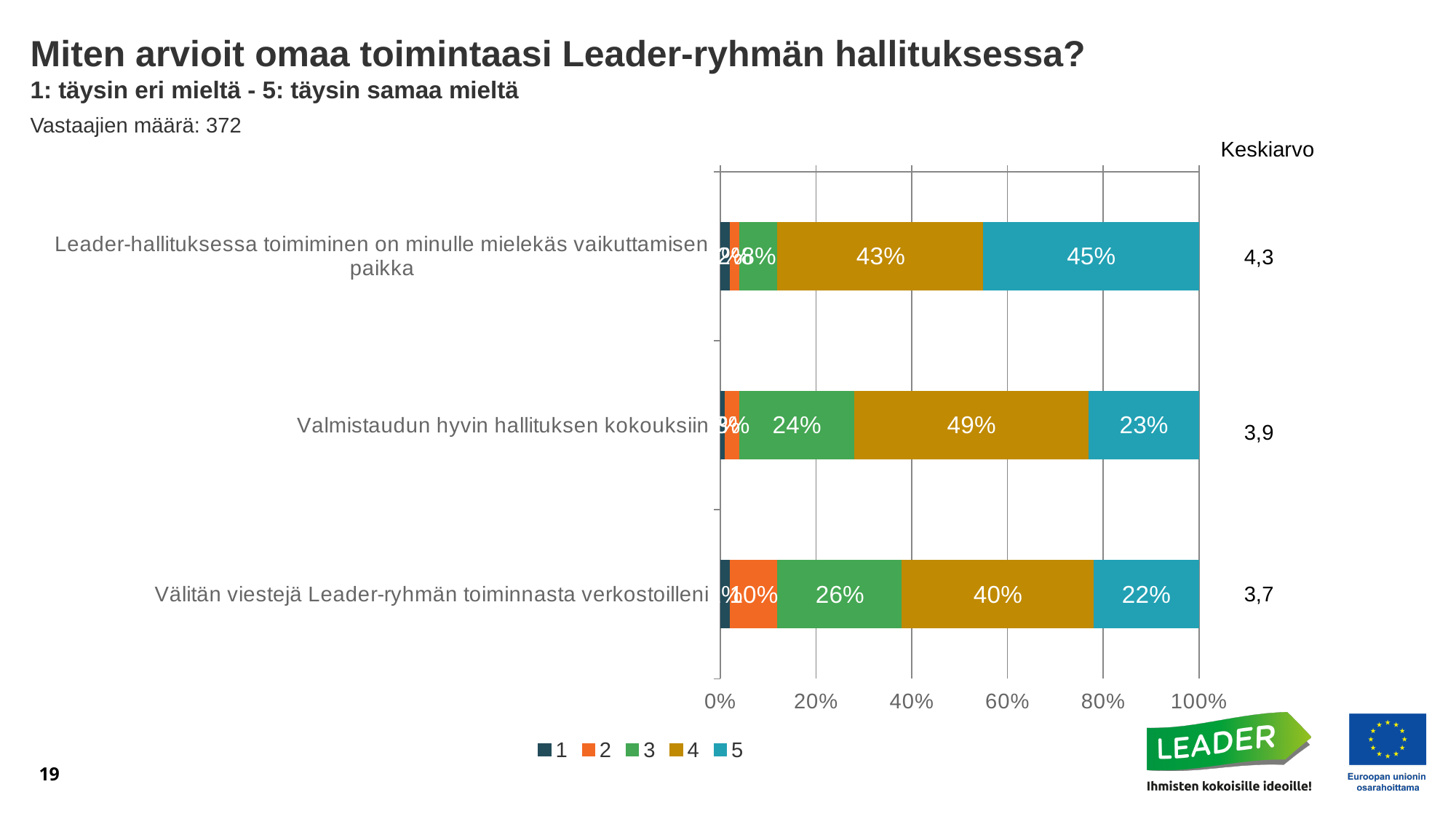
Which category has the lowest value for series 5? Välitän viestejä Leader-ryhmän toiminnasta verkostoilleni What is the value for series 3 in the category 'Välitän viestejä Leader-ryhmän toiminnasta verkostoilleni'? 26% How many categories (statements) are plotted in the chart? 3 Which category has the highest Keskiarvo value? Leader-hallituksessa toimiminen on minulle mielekäs vaikuttamisen paikka What is the difference between the series 4 value and the series 5 value for 'Valmistaudun hyvin hallituksen kokouksiin'? 26% What is the value for series 5 in the category 'Leader-hallituksessa toimiminen on minulle mielekäs vaikuttamisen paikka'? 45% What is the value for series 4 in the category 'Valmistaudun hyvin hallituksen kokouksiin'? 49% What is the value for series 2 in the category 'Välitän viestejä Leader-ryhmän toiminnasta verkostoilleni'? 10% How many series does the legend list? 5 What is the Keskiarvo (average) shown for 'Valmistaudun hyvin hallituksen kokouksiin'? 3,9 What kind of chart is shown on the slide? stacked bar chart Which is larger: the series 4 value for 'Leader-hallituksessa toimiminen on minulle mielekäs vaikuttamisen paikka' or the series 4 value for 'Välitän viestejä Leader-ryhmän toiminnasta verkostoilleni'? Leader-hallituksessa toimiminen on minulle mielekäs vaikuttamisen paikka